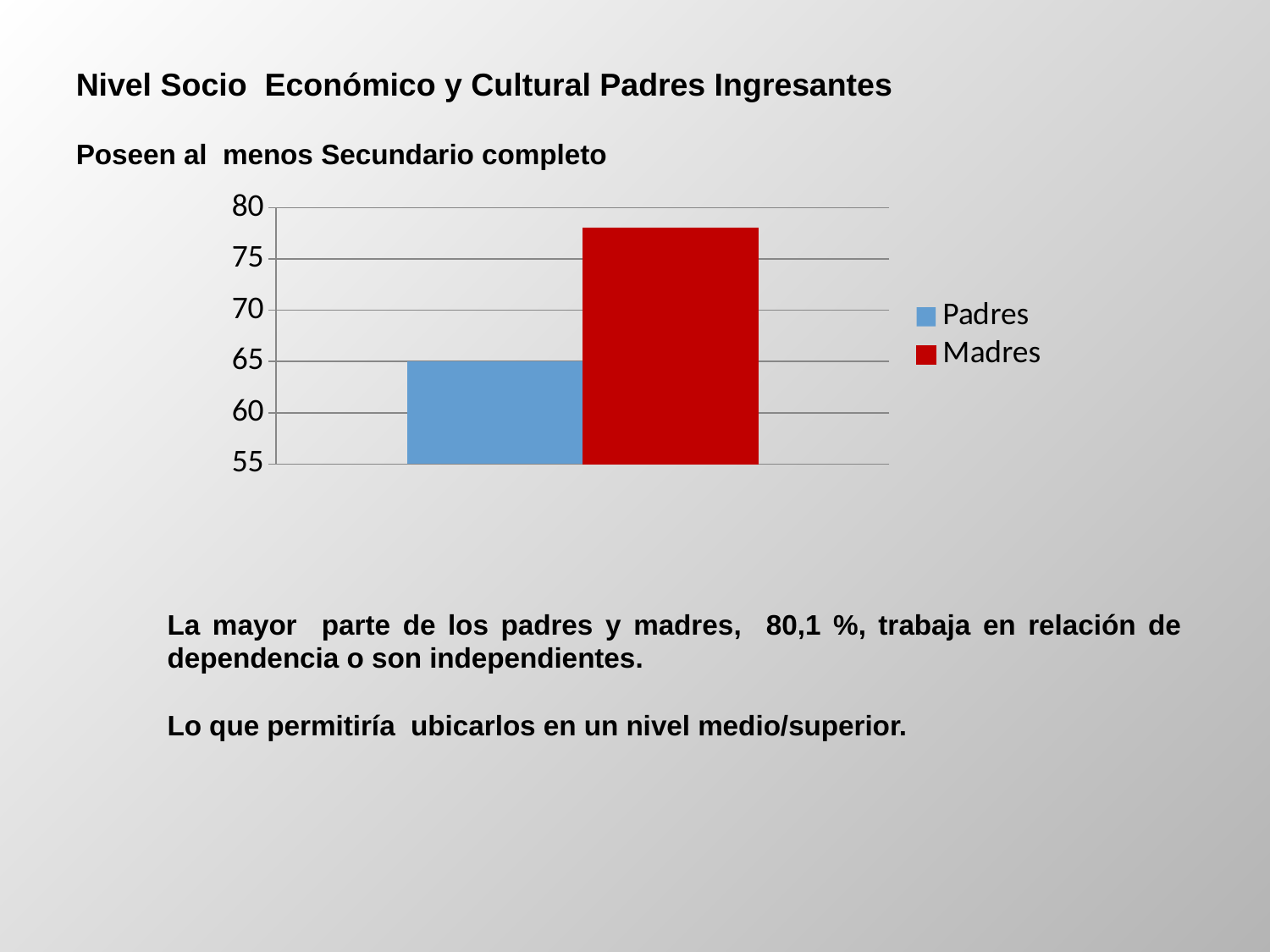
What is the lowest value shown on the vertical axis? 55 How many series does the legend list? 2 What is the value for Padres in the chart? 65 Which series has the highest value in the chart? Madres How many bars are plotted in the chart? 2 What kind of chart is shown on the slide? bar chart Which series has the lowest value in the chart? Padres What colour is the bar for Madres? red Which series has the higher value, Padres or Madres? Madres Is the value for Madres greater or less than 75? greater Is the value for Madres greater or less than 80? less Is the value for Padres greater or less than 70? less